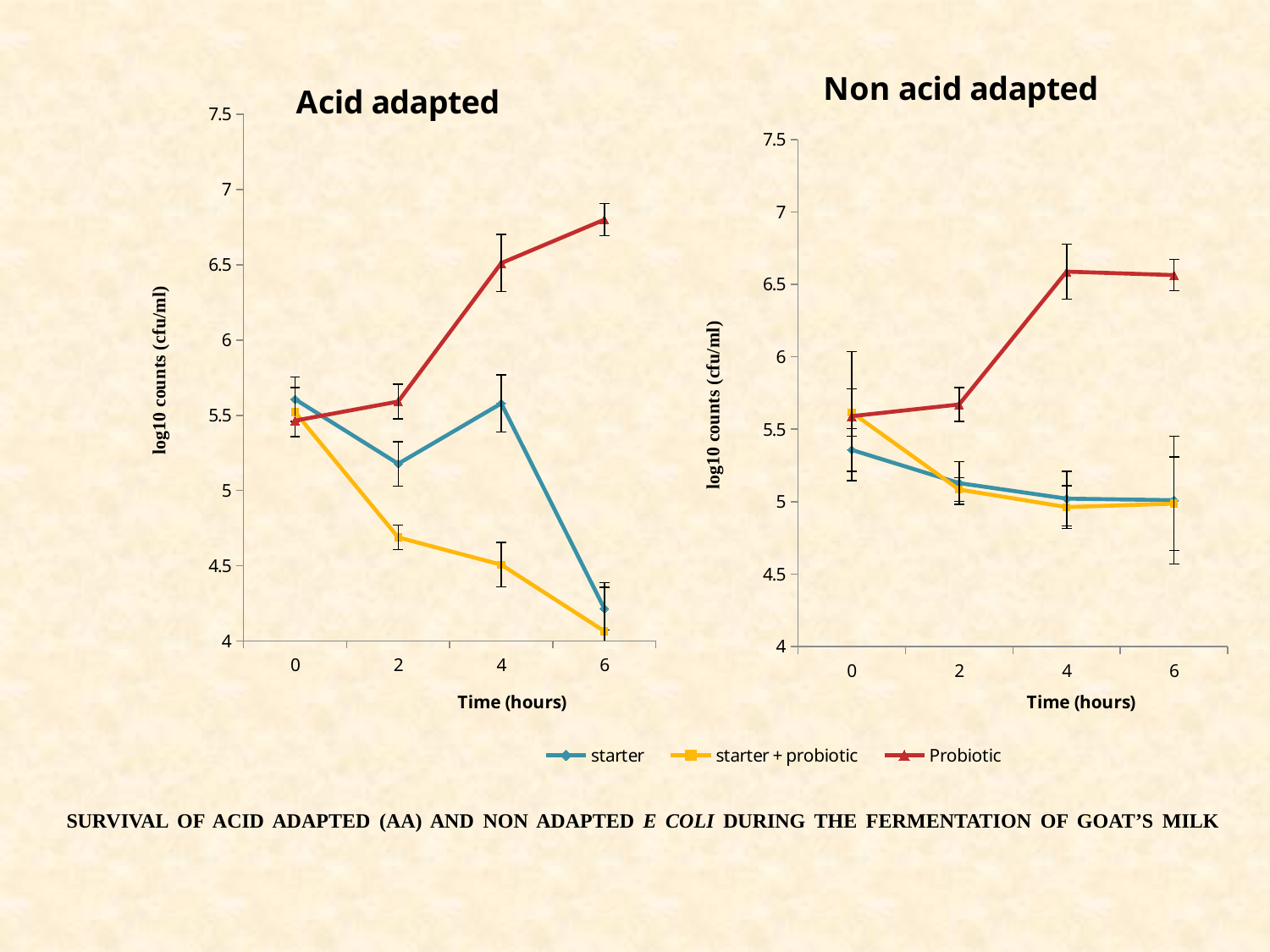
What kind of chart is the Acid adapted chart? line chart In the Acid adapted chart, does the Probiotic series rise or fall from 0 to 6 hours? rise In the Acid adapted chart, does the starter + probiotic series rise or fall from 0 to 6 hours? fall In the Acid adapted chart, at 2 hours, which is higher: starter or starter + probiotic? starter In the Non acid adapted chart, which series has the highest value at 4 hours? Probiotic In the Acid adapted chart, is the starter + probiotic value at 6 hours greater or less than 4.5? less What is the y-axis label of the Non acid adapted chart? log10 counts (cfu/ml) In the Non acid adapted chart, is the Probiotic value at 4 hours greater or less than 6? greater How many time points are plotted on the x axis of the Non acid adapted chart? 4 How many series does the legend list? 3 In the Acid adapted chart, is the Probiotic value at 6 hours greater or less than 6.5? greater In the Acid adapted chart, which series has the lowest value at 4 hours? starter + probiotic